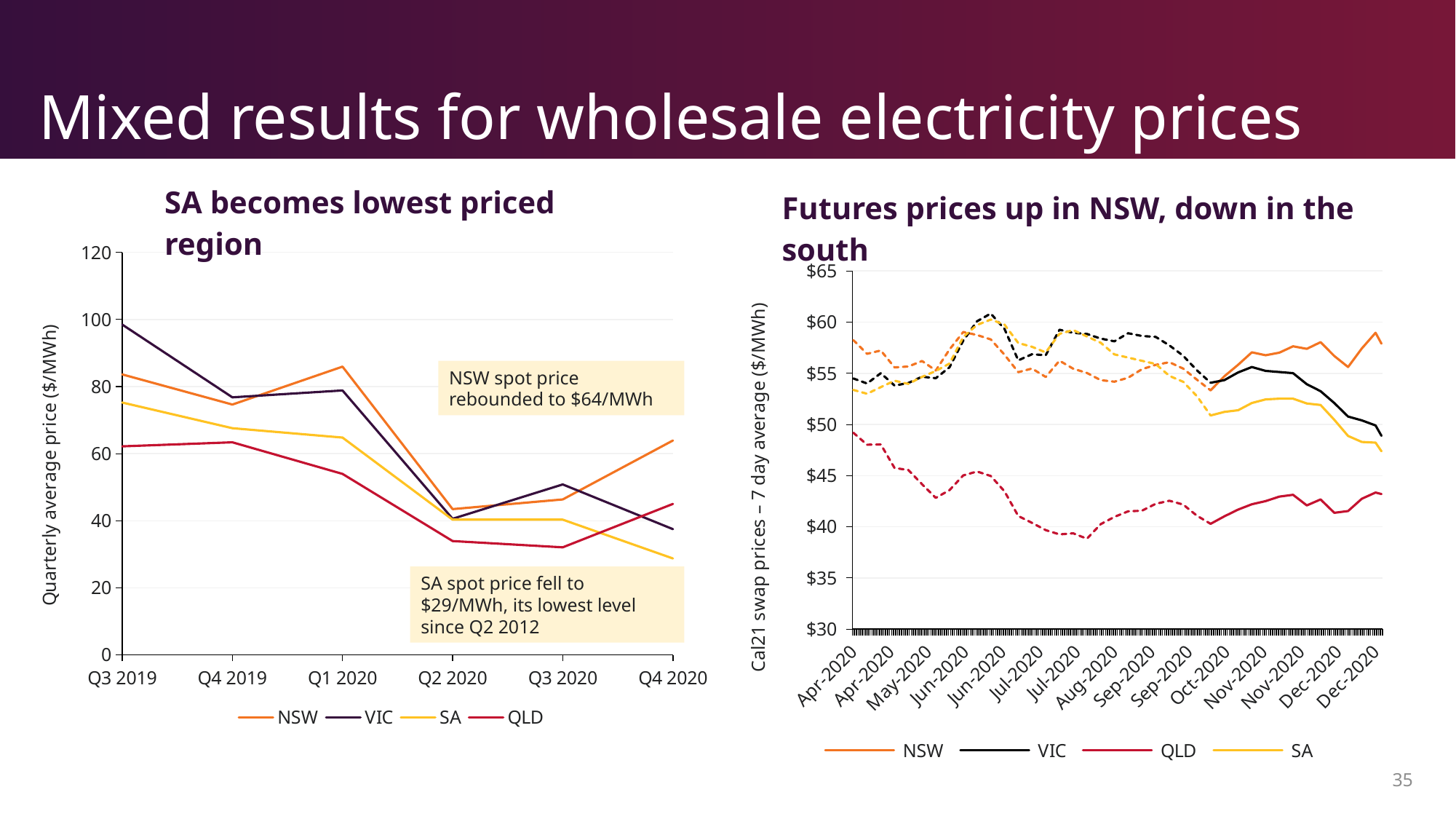
In the left chart 'SA becomes lowest priced region', what was the NSW spot price in Q4 2020 according to the annotation? $64/MWh In the left chart 'SA becomes lowest priced region', which region had the lowest price in Q4 2020? SA What kind of chart is the left chart titled 'SA becomes lowest priced region'? line chart In the left chart 'SA becomes lowest priced region', which region had the highest price in Q3 2019? VIC In the left chart 'SA becomes lowest priced region', is the value for QLD in Q2 2020 greater or less than 40? less In the left chart 'SA becomes lowest priced region', what was the SA spot price in Q4 2020 according to the annotation? $29/MWh How many series does the legend of the left chart 'SA becomes lowest priced region' list? 4 In the right chart 'Futures prices up in NSW, down in the south', which is larger in Dec-2020, NSW or QLD? NSW How many quarters are shown on the x axis of the left chart 'SA becomes lowest priced region'? 6 In the left chart 'SA becomes lowest priced region', does the QLD line rise or fall from Q3 2019 to Q3 2020? fall In the left chart 'SA becomes lowest priced region', what is the difference between the NSW and SA spot prices in Q4 2020? $35/MWh How many series does the legend of the right chart 'Futures prices up in NSW, down in the south' list? 4